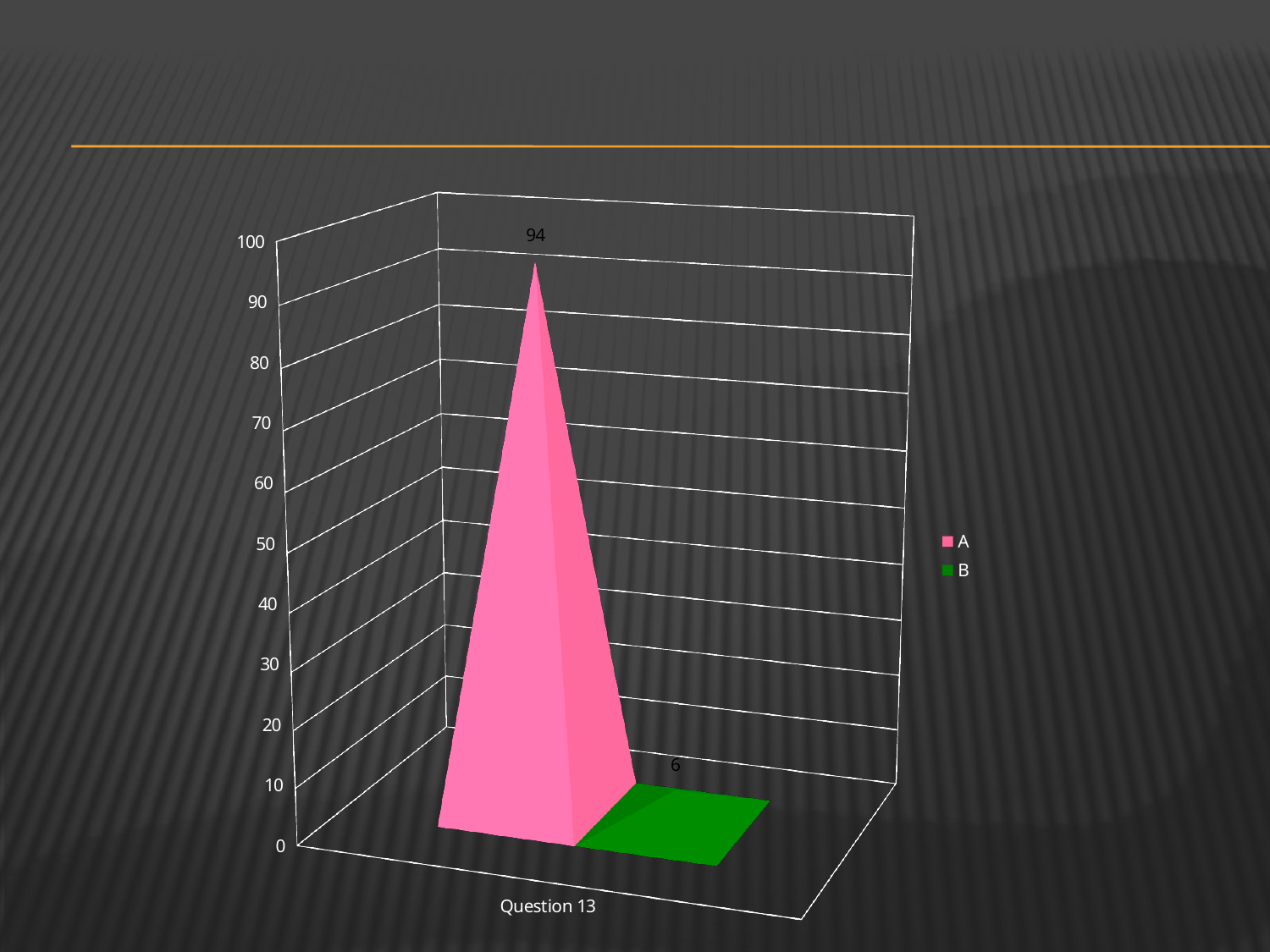
What is the value for series B for Question 13? 6 Is the value for series A greater or less than 90? greater Is the value for series B greater or less than 10? less Is the value for series A larger or smaller than the value for series B? larger What is the difference between the values for series A and series B for Question 13? 88 What is the label of the category on the x axis? Question 13 How many series does the legend list? 2 How many categories are shown on the x axis? 1 What kind of chart is shown on the slide? bar chart What is the value for series A for Question 13? 94 Which series has the lower value for Question 13? B Which series has the higher value for Question 13? A